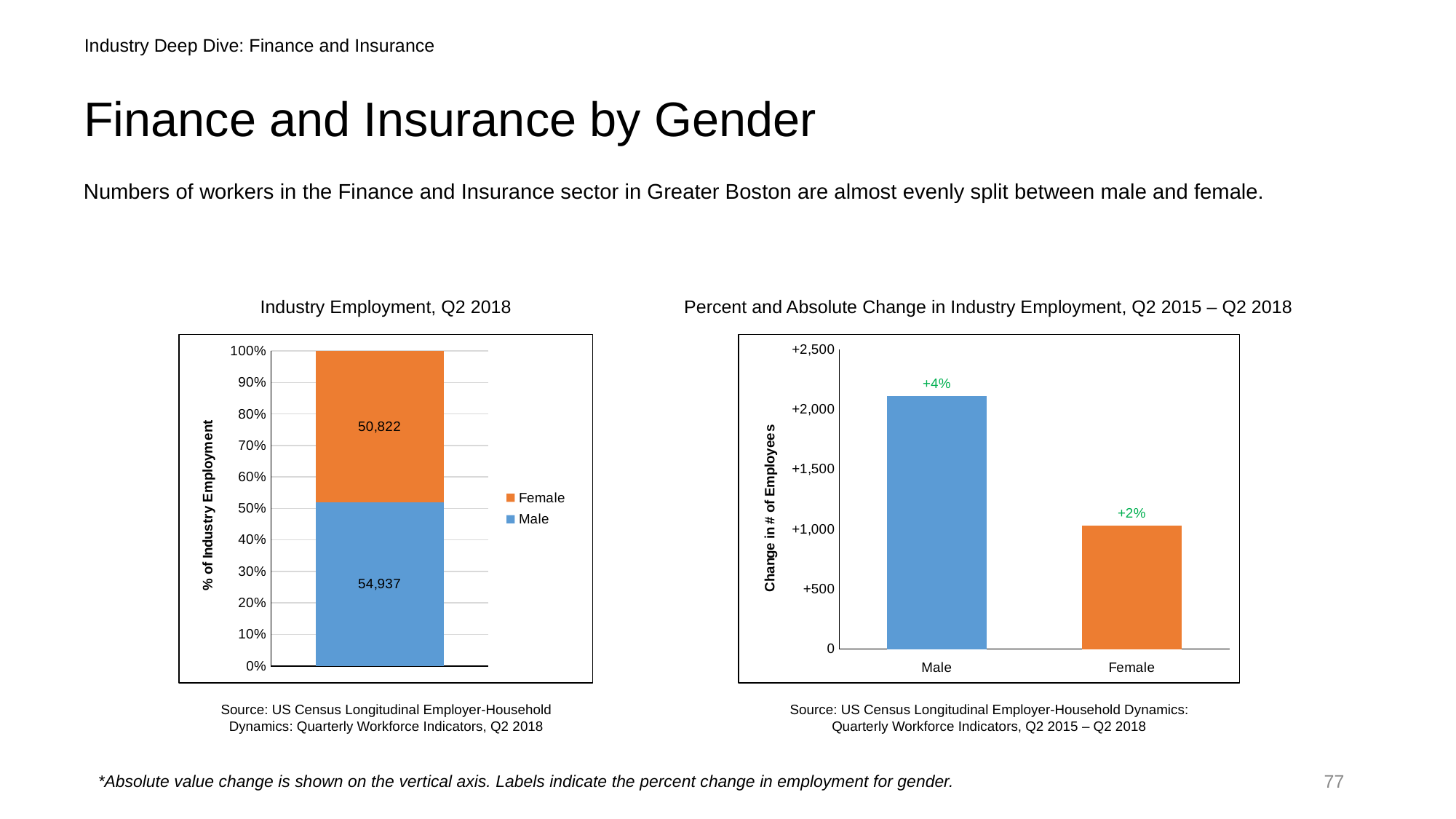
In the 'Industry Employment, Q2 2018' chart, what is the number of Male employees shown on the bar? 54,937 In the 'Percent and Absolute Change in Industry Employment, Q2 2015 – Q2 2018' chart, what percent change label is shown above the Male bar? +4% In the 'Industry Employment, Q2 2018' chart, how many series does the legend list? 2 In the 'Industry Employment, Q2 2018' chart, what is the total of the Male and Female values in the stacked bar? 105,759 In the 'Percent and Absolute Change in Industry Employment, Q2 2015 – Q2 2018' chart, is the change in number of employees for Female greater or less than +1,500? less In the 'Percent and Absolute Change in Industry Employment, Q2 2015 – Q2 2018' chart, is the change in number of employees for Male greater or less than +2,000? greater In the 'Industry Employment, Q2 2018' chart, what is the number of Female employees shown on the bar? 50,822 In the 'Industry Employment, Q2 2018' chart, which is larger, the Male or the Female employee count? Male What kind of chart is the 'Industry Employment, Q2 2018' chart? Stacked bar chart In the 'Percent and Absolute Change in Industry Employment, Q2 2015 – Q2 2018' chart, which category has the highest change in number of employees? Male In the 'Industry Employment, Q2 2018' chart, what is the difference between the Male and Female employee counts? 4,115 In the 'Percent and Absolute Change in Industry Employment, Q2 2015 – Q2 2018' chart, what percent change label is shown above the Female bar? +2%